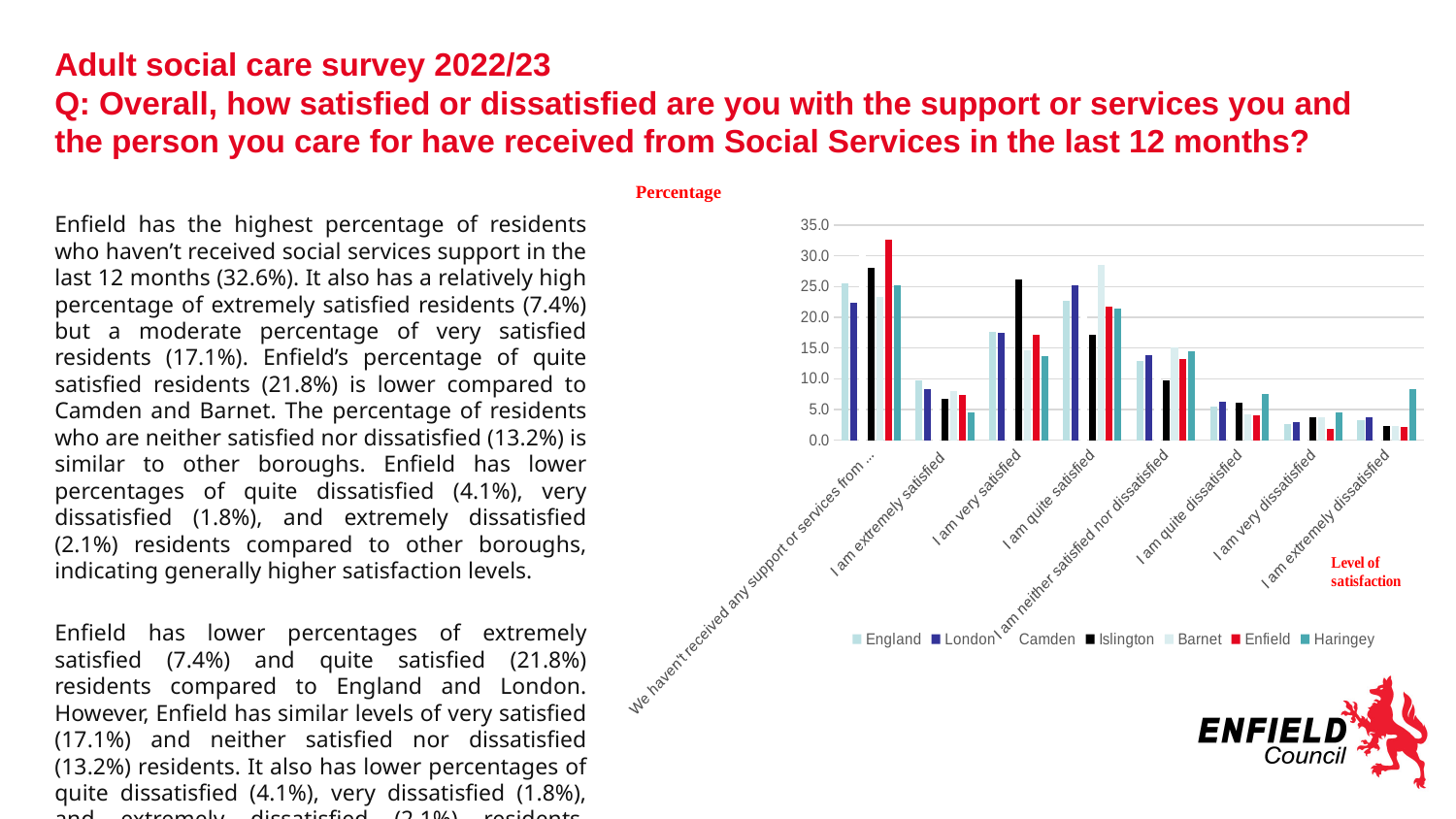
Which series has the lowest bar in the 'I am extremely satisfied' category? Haringey In the 'I am extremely satisfied' category, which is larger: England or Haringey? England How many series does the chart legend list? 7 Is the value for Haringey in the 'I am extremely dissatisfied' category greater or less than 5? greater Which borough has the highest bar in the 'We haven't received any support or services from ...' category? Enfield Which series has the highest bar in the 'I am quite satisfied' category? Barnet In the 'I am very satisfied' category, which is larger: Camden or Haringey? Haringey How many satisfaction categories are shown along the x axis of the chart? 8 What is the title shown on the vertical axis of the chart? Percentage Is the value for Enfield in the 'I am very dissatisfied' category greater or less than 5? less What kind of chart is shown on the slide? bar chart Is the value for Enfield in the 'We haven't received any support or services from ...' category greater or less than 30? greater